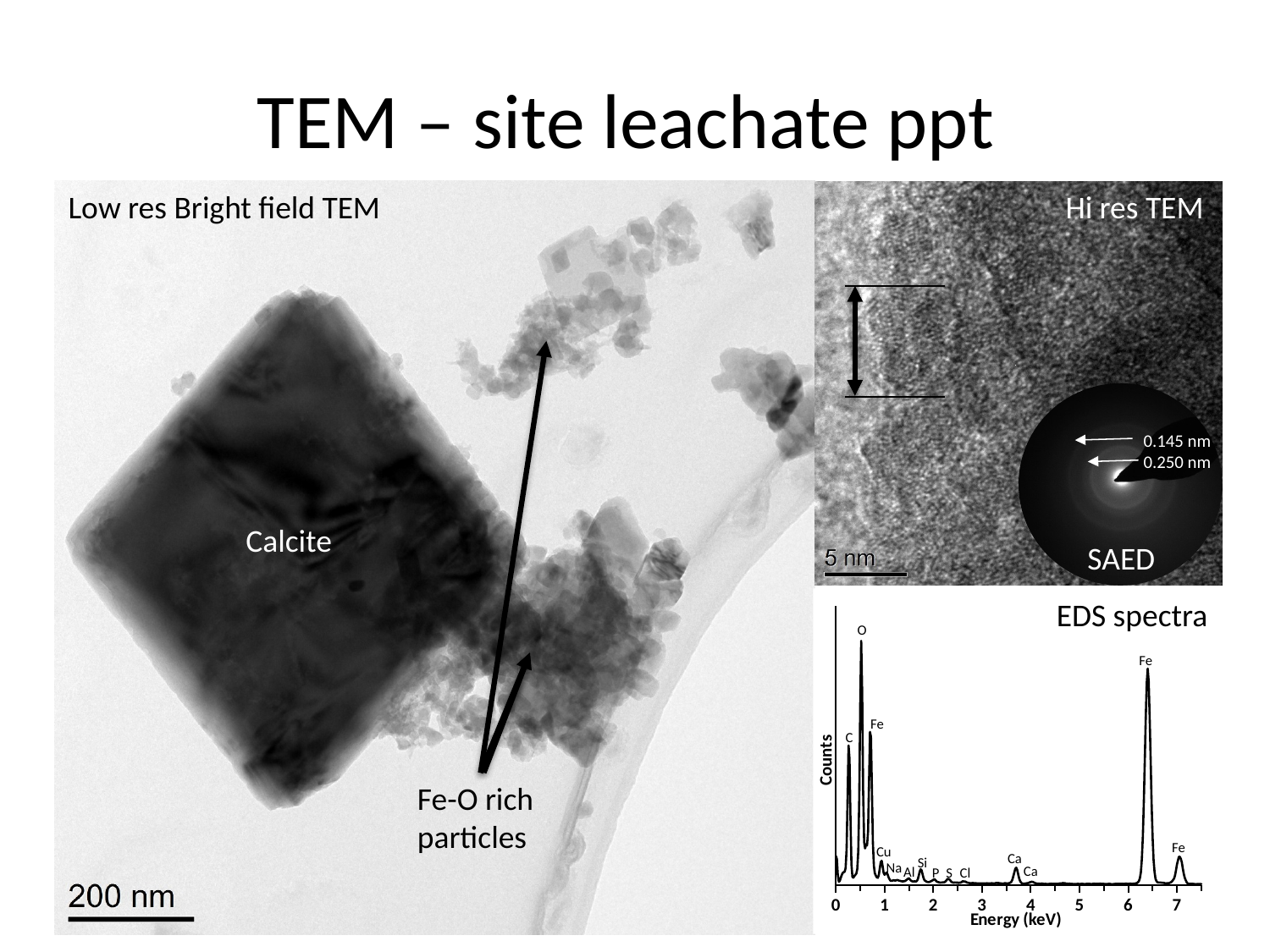
On the EDS spectra chart, how many numbered tick marks are on the x axis? 8 What kind of chart is the EDS spectra chart? line chart On the EDS spectra chart, what is the label of the x axis? Energy (keV) On the EDS spectra chart, which is taller: the Fe peak near 0.7 keV or the Fe peak near 7 keV? the Fe peak near 0.7 keV On the EDS spectra chart, what is the label of the y axis? Counts On the EDS spectra chart, how many peaks are labelled Fe? 3 On the EDS spectra chart, which labelled element has the tallest peak? O On the EDS spectra chart, which is taller: the O peak or the Fe peak near 6.4 keV? O On the EDS spectra chart, how many peaks are labelled Ca? 2 On the EDS spectra chart, is the energy of the large Fe peak greater or less than 6 keV? greater On the EDS spectra chart, what is the highest tick value shown on the x axis? 7 On the EDS spectra chart, is the energy of the O peak greater or less than 1 keV? less